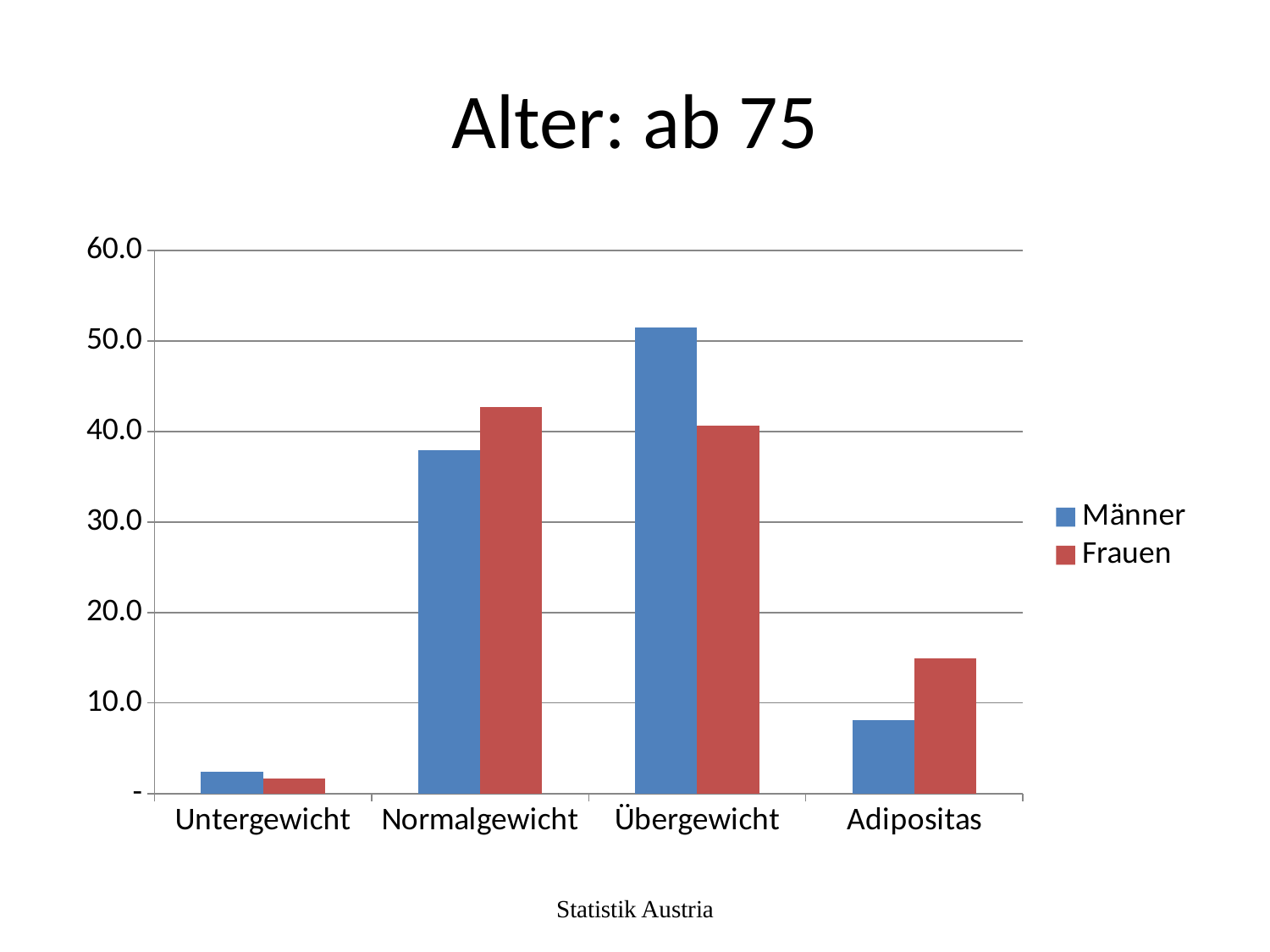
Which category has the lowest value for Frauen? Untergewicht In the Übergewicht category, which is larger, Männer or Frauen? Männer How many categories are shown on the x axis? 4 Which category has the highest value for Männer? Übergewicht Is the value for Männer in Normalgewicht greater or less than 40.0? less Which category has the highest value for Frauen? Normalgewicht Is the value for Frauen in Adipositas greater or less than 10.0? greater In the Adipositas category, which is larger, Männer or Frauen? Frauen What kind of chart is shown on the slide? bar chart Is the value for Männer in Übergewicht greater or less than 50.0? greater How many series does the legend list? 2 What is the title of the chart? Alter: ab 75